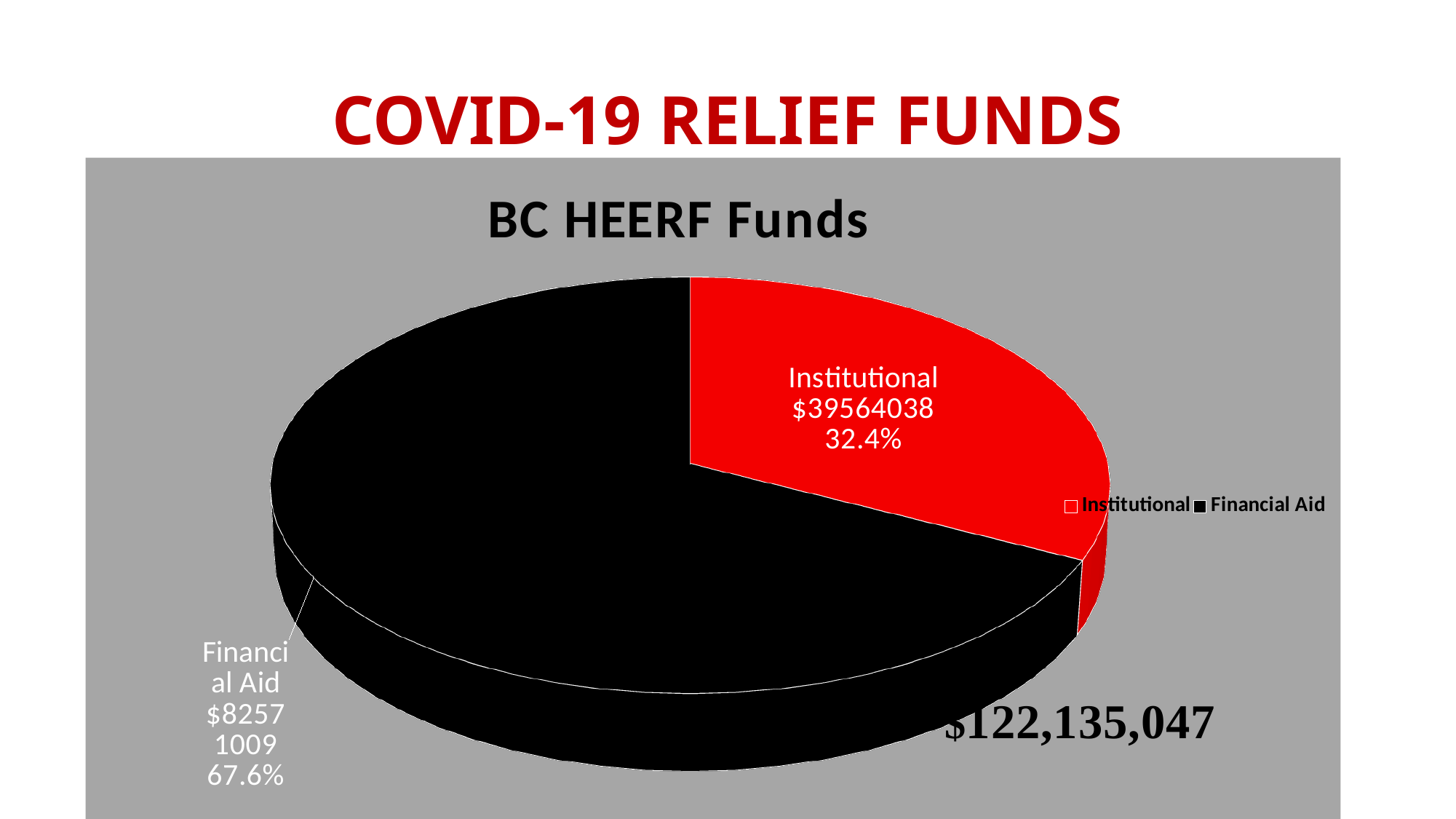
Which is larger, Institutional or Financial Aid? Financial Aid What share of the pie does the Financial Aid slice represent? 67.6% Which slice is the largest? Financial Aid What is the title of the chart? BC HEERF Funds What is the difference between the Financial Aid value and the Institutional value? $43006971 Which slice is the smallest? Institutional What type of chart is shown on the slide? pie chart What is the value shown for the Institutional slice? $39564038 How many entries does the legend list? 2 What is the value shown for the Financial Aid slice? $82571009 How many slices does the pie chart have? 2 What share of the pie does the Institutional slice represent? 32.4%